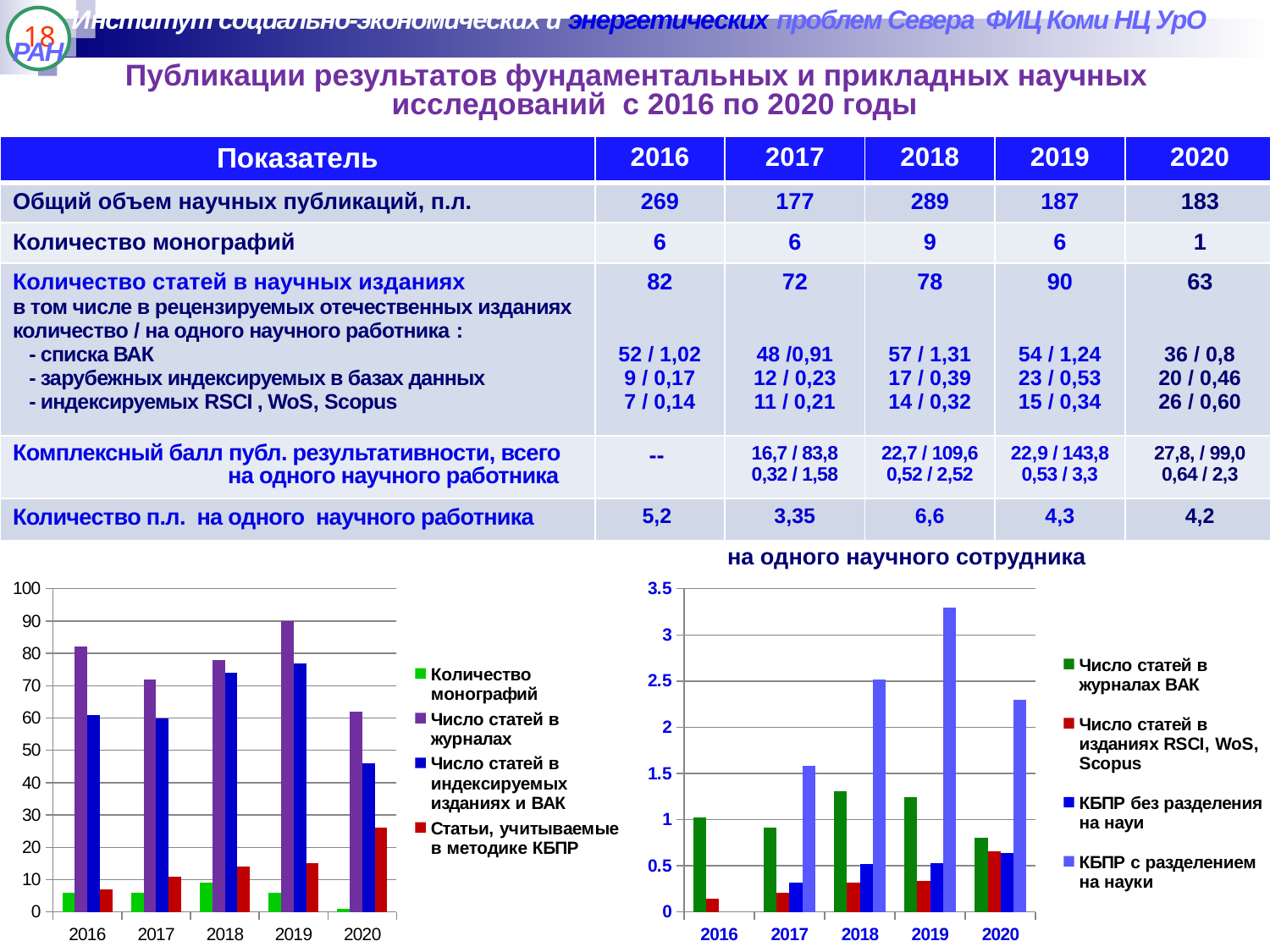
In the chart titled 'на одного научного сотрудника', does the value for Число статей в журналах ВАК rise or fall from 2018 to 2020? fall How many years are shown on the x axis of the left chart? 5 What kind of chart is the chart on the left of the slide? bar chart How many series does the legend of the left chart list? 4 In the chart titled 'на одного научного сотрудника', is the value for КБПР с разделением на науки in 2019 greater or less than 3? greater In the left chart, is the value for Статьи, учитываемые в методике КБПР in 2020 greater or less than 20? greater What is the title of the chart on the right of the slide? на одного научного сотрудника In the left chart, is the value for Число статей в журналах in 2016 greater or less than 80? greater In the left chart, which year has the larger value for Число статей в индексируемых изданиях и ВАК, 2018 or 2020? 2018 In the left chart, which year has the lowest value for Количество монографий? 2020 In the chart titled 'на одного научного сотрудника', which year has the highest value for КБПР с разделением на науки? 2019 In the left chart, which year has the highest value for Число статей в журналах? 2019